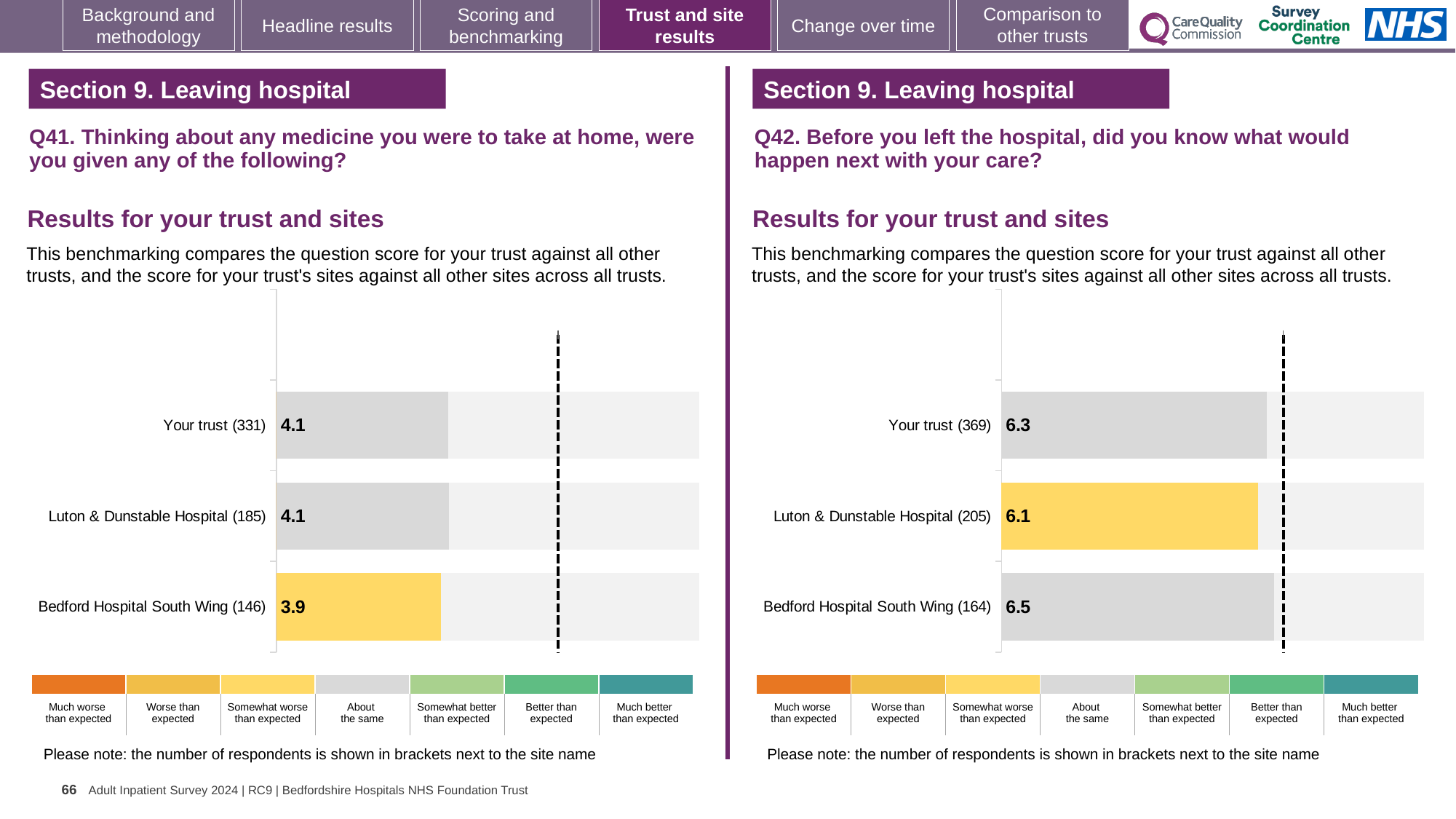
In the Q42 chart on the right, what is the score for Luton & Dunstable Hospital? 6.1 In the Q41 chart on the left, what is the difference between the scores for Your trust and Bedford Hospital South Wing? 0.2 In the Q42 chart on the right, which site or trust has the highest score? Bedford Hospital South Wing In the Q42 chart on the right, what is the difference between the scores for Bedford Hospital South Wing and Luton & Dunstable Hospital? 0.4 In the Q42 chart on the right, how many respondents are shown in brackets for Your trust? 369 What type of chart is used for the Q42 results on the right? Bar chart In the Q41 chart on the left, which site or trust has the lowest score? Bedford Hospital South Wing In the Q41 chart on the left, what is the score for Your trust? 4.1 How many bars are shown in the Q41 chart on the left? 3 In the Q41 chart on the left, what is the score for Bedford Hospital South Wing? 3.9 In the Q42 chart on the right, what is the score for Bedford Hospital South Wing? 6.5 In the Q42 chart on the right, which has the higher score, Your trust or Luton & Dunstable Hospital? Your trust